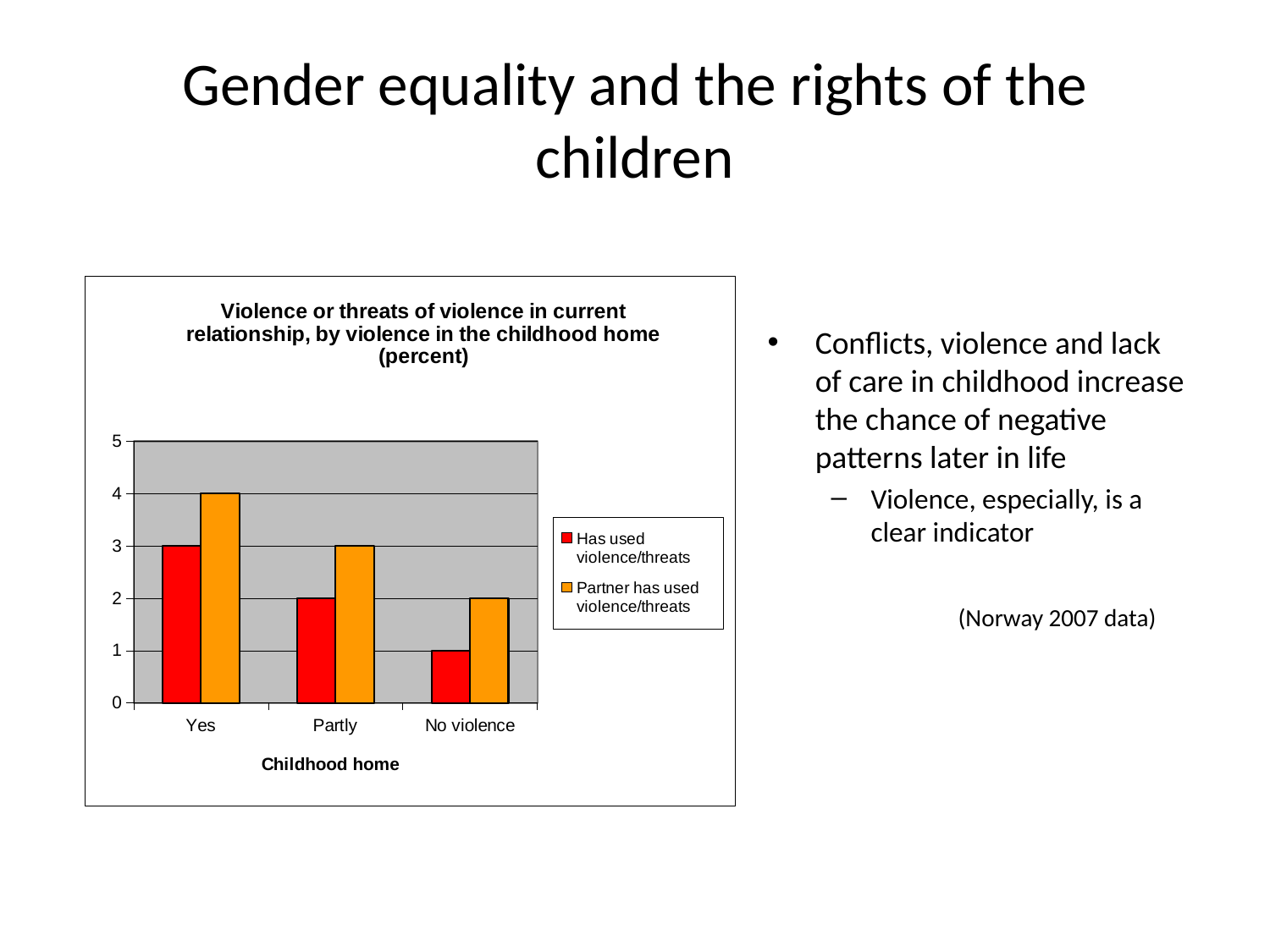
What is the value for 'Partner has used violence/threats' in the 'Yes' category? 4 What is the value for 'Has used violence/threats' in the 'No violence' category? 1 How many categories are shown on the x axis of the chart? 3 Which childhood home category has the lowest value for 'Has used violence/threats'? No violence Which childhood home category has the highest value for 'Partner has used violence/threats'? Yes What is the value for 'Partner has used violence/threats' in the 'Partly' category? 3 What type of chart is shown on the slide? bar chart What is the x-axis title of the chart? Childhood home How many series does the chart's legend list? 2 What is the difference between the 'Partner has used violence/threats' and 'Has used violence/threats' values in the 'Partly' category? 1 Do the values for 'Has used violence/threats' rise or fall from 'Yes' to 'No violence' along the x axis? fall What is the value for 'Has used violence/threats' in the 'Yes' category? 3